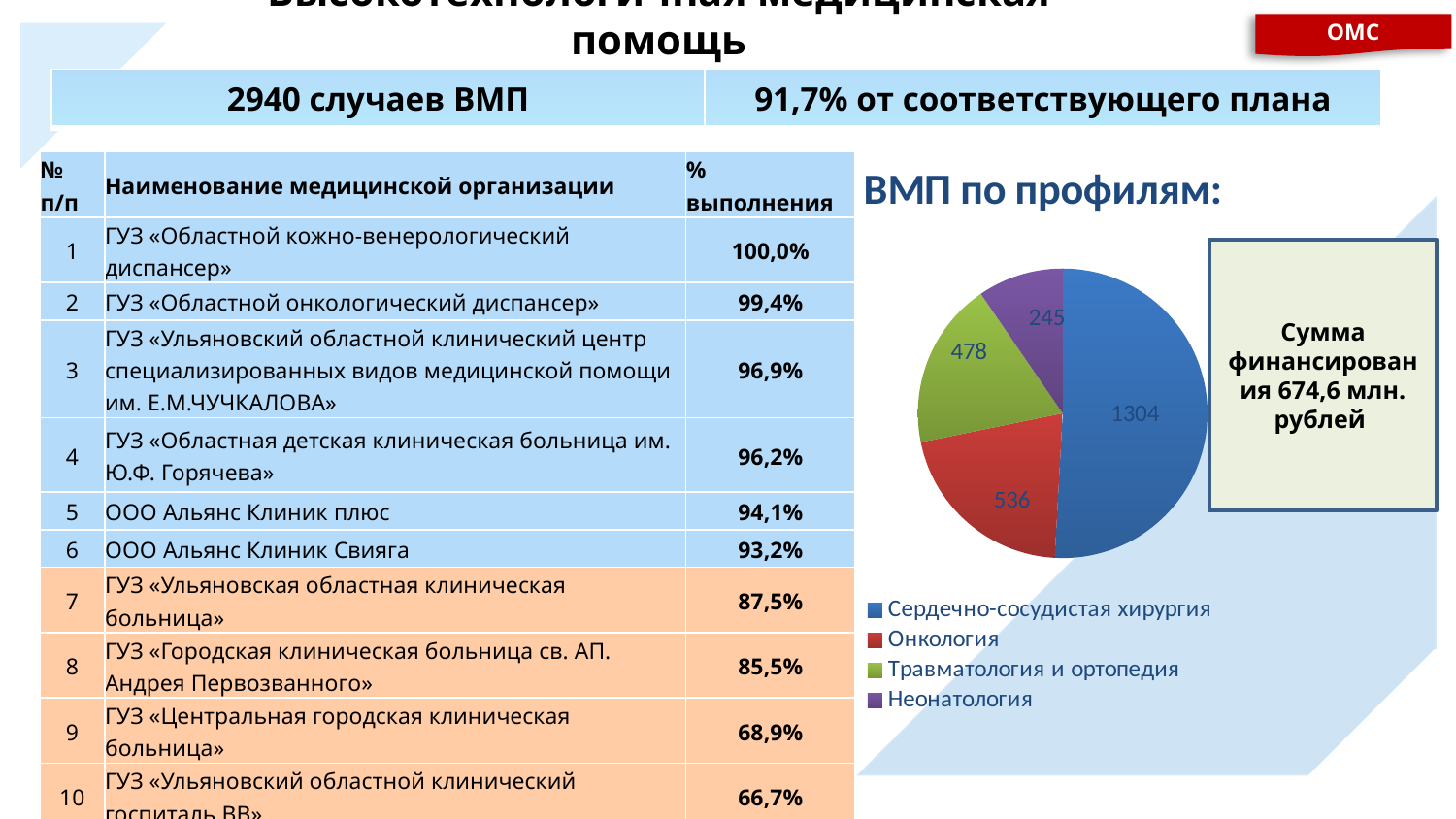
How many slices does the pie chart "ВМП по профилям:" have? 4 In the pie chart "ВМП по профилям:", which is larger: Онкология or Травматология и ортопедия? Онкология What kind of chart is shown under the heading "ВМП по профилям:"? pie chart In the pie chart "ВМП по профилям:", what is the value for Сердечно-сосудистая хирургия? 1304 In the pie chart "ВМП по профилям:", what is the difference between the values for Сердечно-сосудистая хирургия and Онкология? 768 In the pie chart "ВМП по профилям:", what is the value for Онкология? 536 Which profile has the largest slice in the pie chart "ВМП по профилям:"? Сердечно-сосудистая хирургия Which profile has the smallest slice in the pie chart "ВМП по профилям:"? Неонатология In the pie chart "ВМП по профилям:", what is the value for Травматология и ортопедия? 478 In the pie chart "ВМП по профилям:", what colour is the slice for Травматология и ортопедия? green In the pie chart "ВМП по профилям:", what is the value for Неонатология? 245 In the pie chart "ВМП по профилям:", what is the difference between the values for Травматология и ортопедия and Неонатология? 233